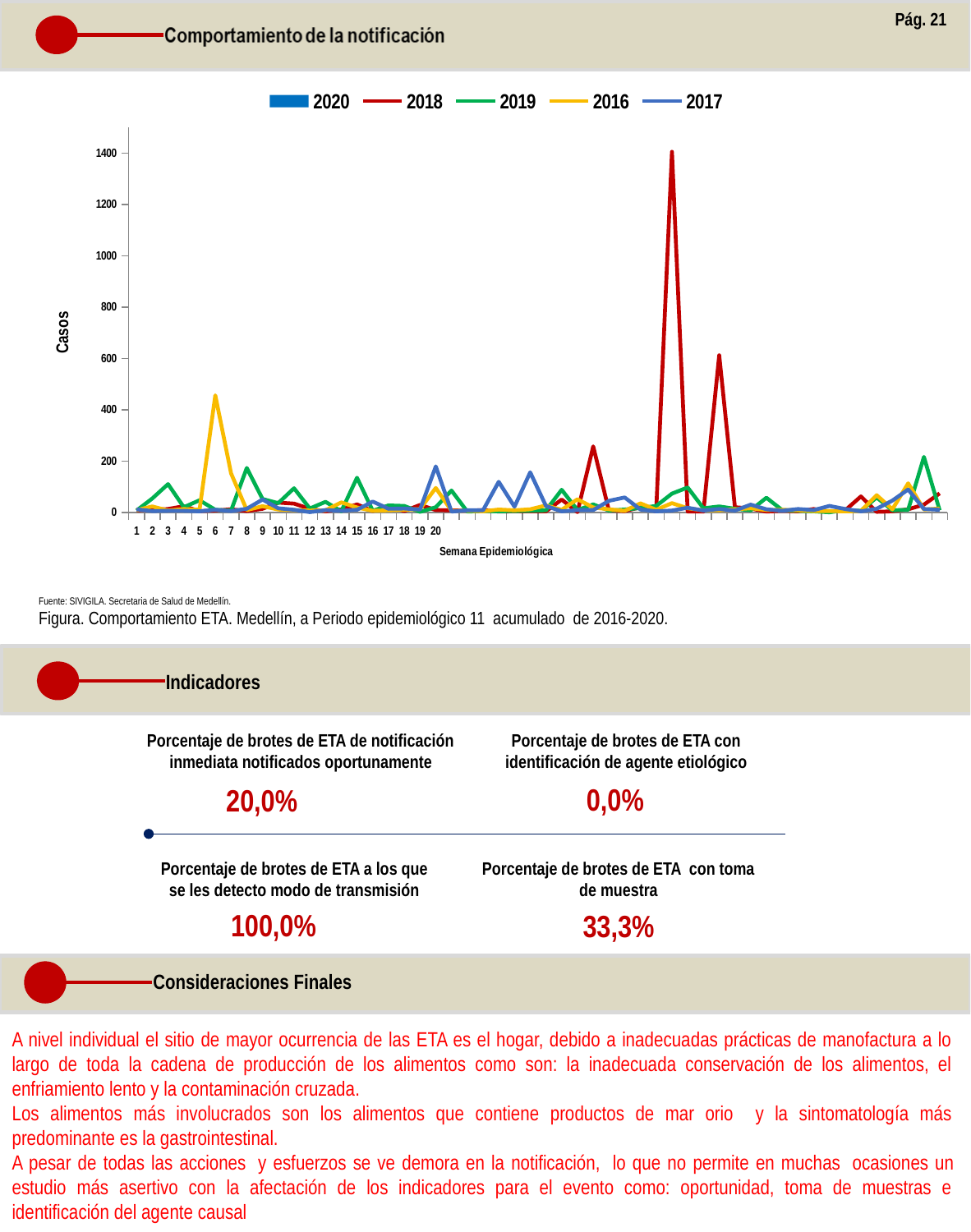
Is the peak of the 2016 series at week 6 greater or less than 400? greater How many series does the chart legend list? 5 What kind of chart is shown on the slide? combination bar and line chart Which series has the higher peak value, 2018 or 2016? 2018 Which series has the higher value at week 20, 2017 or 2018? 2017 Is the highest value of the 2018 series greater or less than 1200? greater Which series reaches the highest value on the chart? 2018 Is the value of the 2017 series at week 20 greater or less than 100? greater What is the title of the chart's horizontal axis? Semana Epidemiológica What is the title of the chart's vertical axis? Casos Which series has the higher value at week 6, 2016 or 2019? 2016